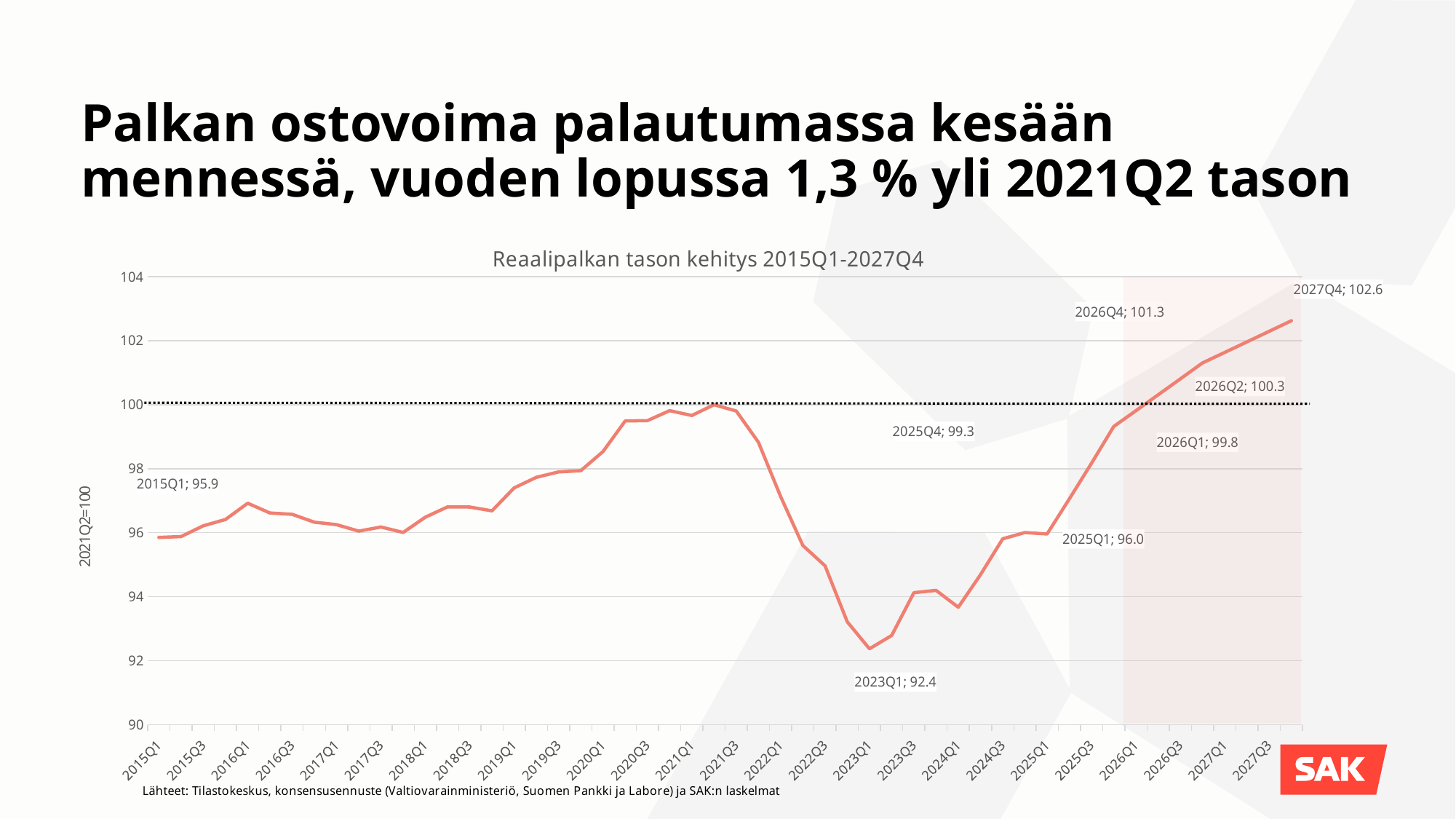
Which quarter has the lowest value on the chart? 2023Q1 What is the difference between the values for 2026Q4 and 2025Q4? 2.0 What is the difference between the values for 2027Q4 and 2023Q1? 10.2 Is the value for 2022Q3 greater or less than 96? less What is the value for 2023Q1? 92.4 What type of chart is shown on the slide? line chart Which quarter has the highest value on the chart? 2027Q4 What is the title of the chart? Reaalipalkan tason kehitys 2015Q1-2027Q4 Does the line rise or fall between 2021Q3 and 2023Q1? fall What is the value for 2027Q4? 102.6 What is the value for 2015Q1? 95.9 What is the value for 2026Q2? 100.3